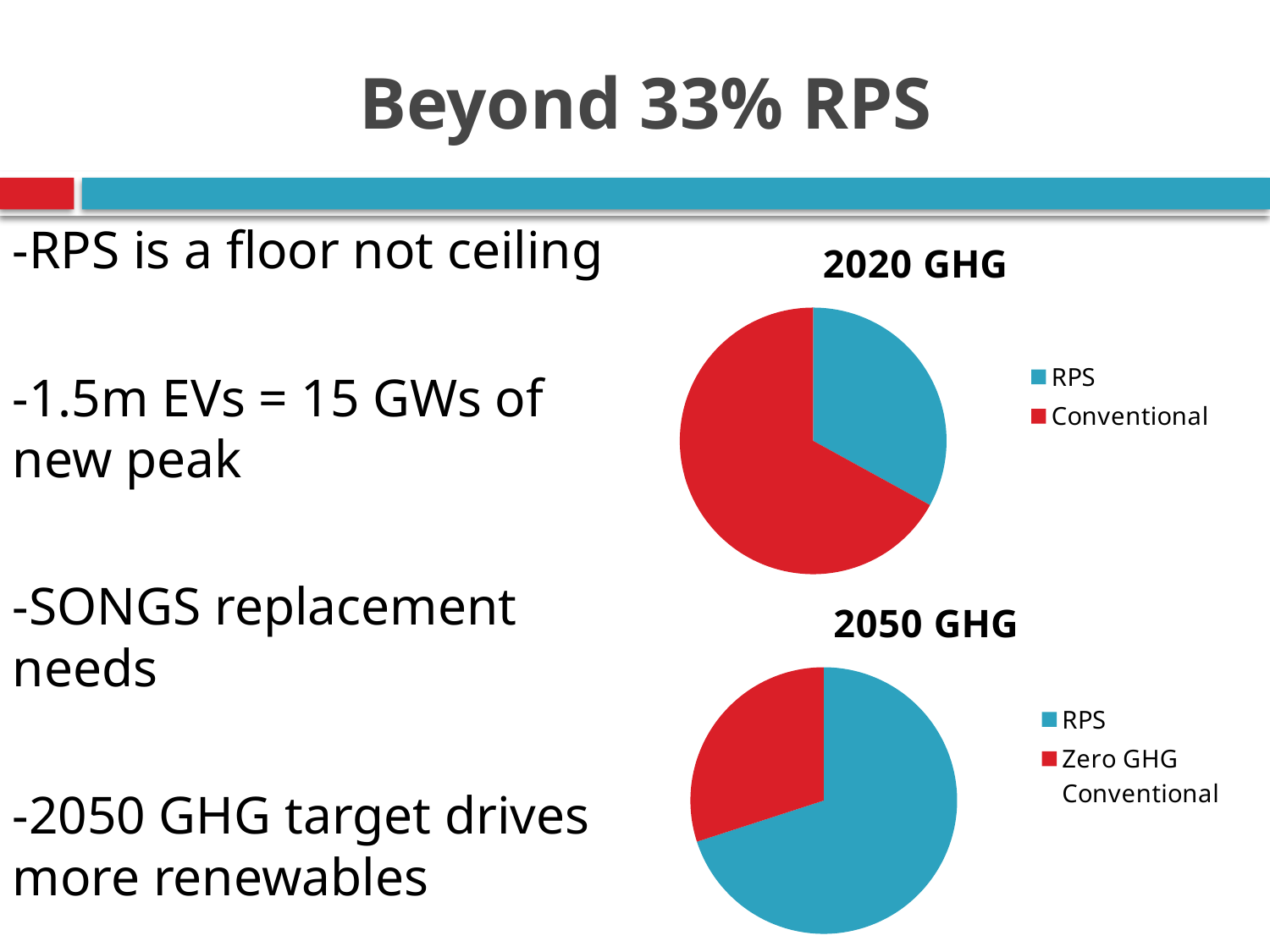
In the "2020 GHG" chart, which is larger, the RPS slice or the Conventional slice? Conventional What kind of chart is the "2050 GHG" chart? pie chart In the "2020 GHG" chart, which slice is the largest? Conventional How many slices does the "2020 GHG" pie chart have? 2 In the "2050 GHG" chart, which is larger, the RPS slice or the Zero GHG Conventional slice? RPS How many entries does the legend of the "2050 GHG" chart list? 2 In the "2050 GHG" chart, which slice is the largest? RPS What colour is the RPS slice in the "2020 GHG" chart? blue In the "2020 GHG" chart, which slice is the smallest? RPS What kind of chart is the "2020 GHG" chart? pie chart What is the title of the lower pie chart on the slide? 2050 GHG In the "2050 GHG" chart, which slice is the smallest? Zero GHG Conventional